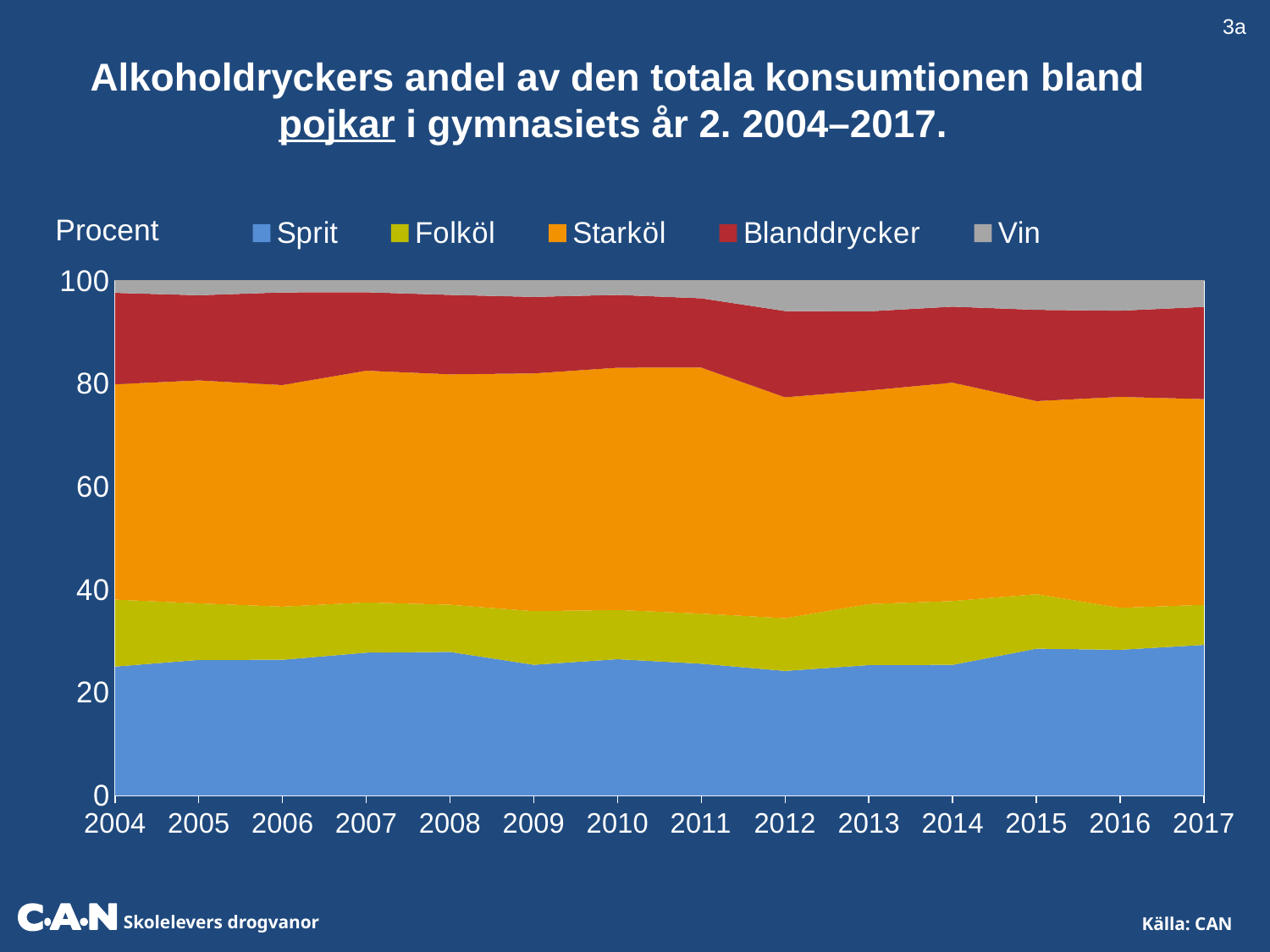
Is the value for Sprit in 2004 greater or less than 40? less In 2010, which is larger: the share for Starköl or the share for Sprit? Starköl How many years are shown along the x axis? 14 Which series is shown in orange in the legend? Starköl In 2017, which is larger: the share for Sprit or the share for Folköl? Sprit Which beverage category accounts for the largest share of total consumption across the years shown? Starköl How many series does the legend list? 5 What label is shown on the y axis of the chart? Procent Is the value for Sprit in 2017 greater or less than 20? greater What kind of chart is shown on the slide? Stacked area chart Does the share for Vin rise or fall from 2004 to 2017? rise Which beverage category accounts for the smallest share of total consumption across the years shown? Vin